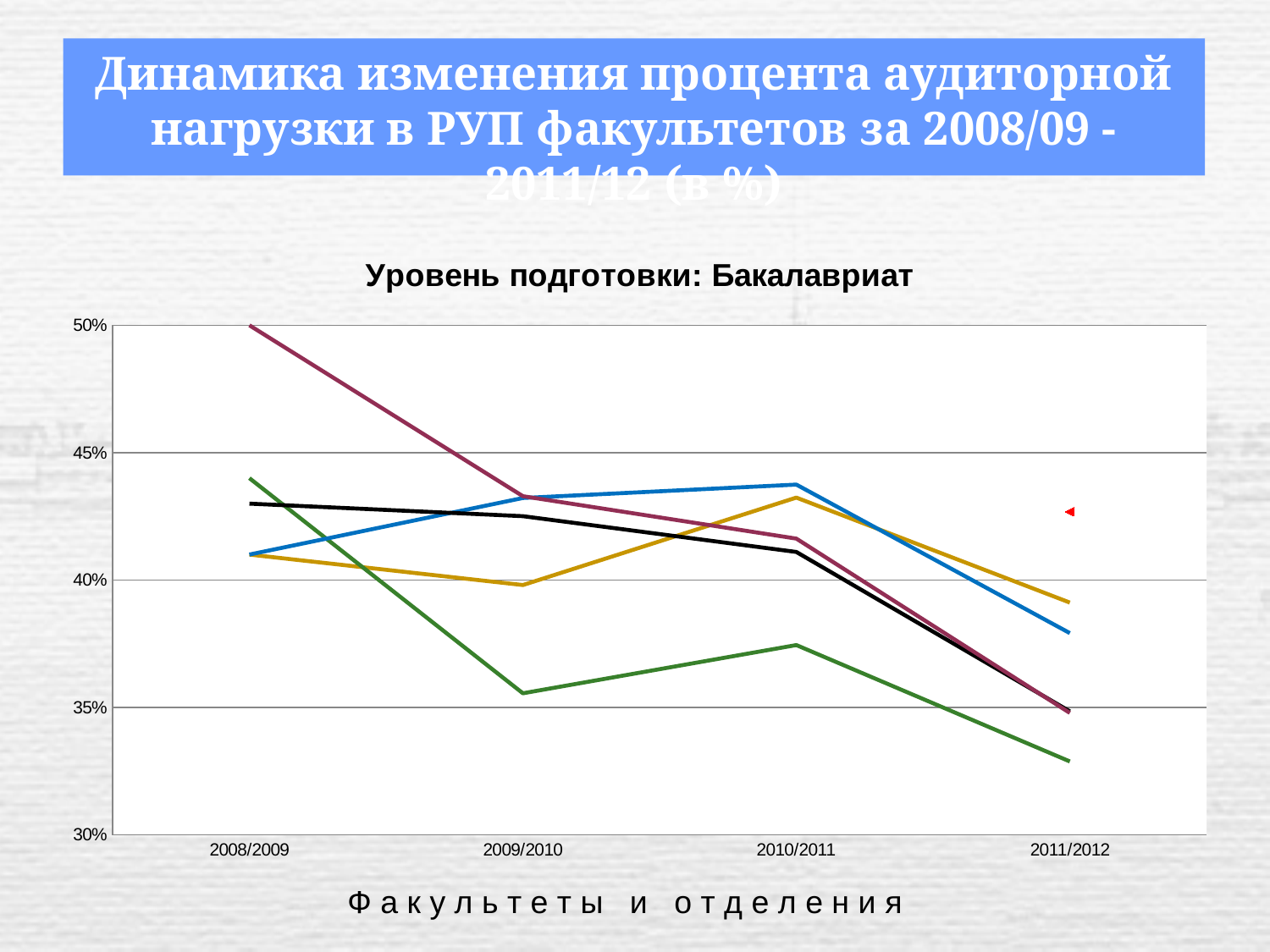
Is the value of the blue line at 2010/2011 greater or less than 40%? greater How many lines are plotted on the chart? 5 Is the value of the green line at 2011/2012 greater or less than 35%? less Is the value of the purple line at 2008/2009 greater or less than 45%? greater How many academic years are shown along the x axis of the chart? 4 Between 2010/2011 and 2011/2012, do all the lines rise or fall? fall In which year does the purple line reach its highest value? 2008/2009 What label is printed below the x axis of the chart? Факультеты и отделения What kind of chart is shown on the slide? line chart In which year does the green line reach its lowest value? 2011/2012 At 2011/2012, which line is higher: the yellow line or the green line? yellow line What is the title printed directly above the chart? Уровень подготовки: Бакалавриат